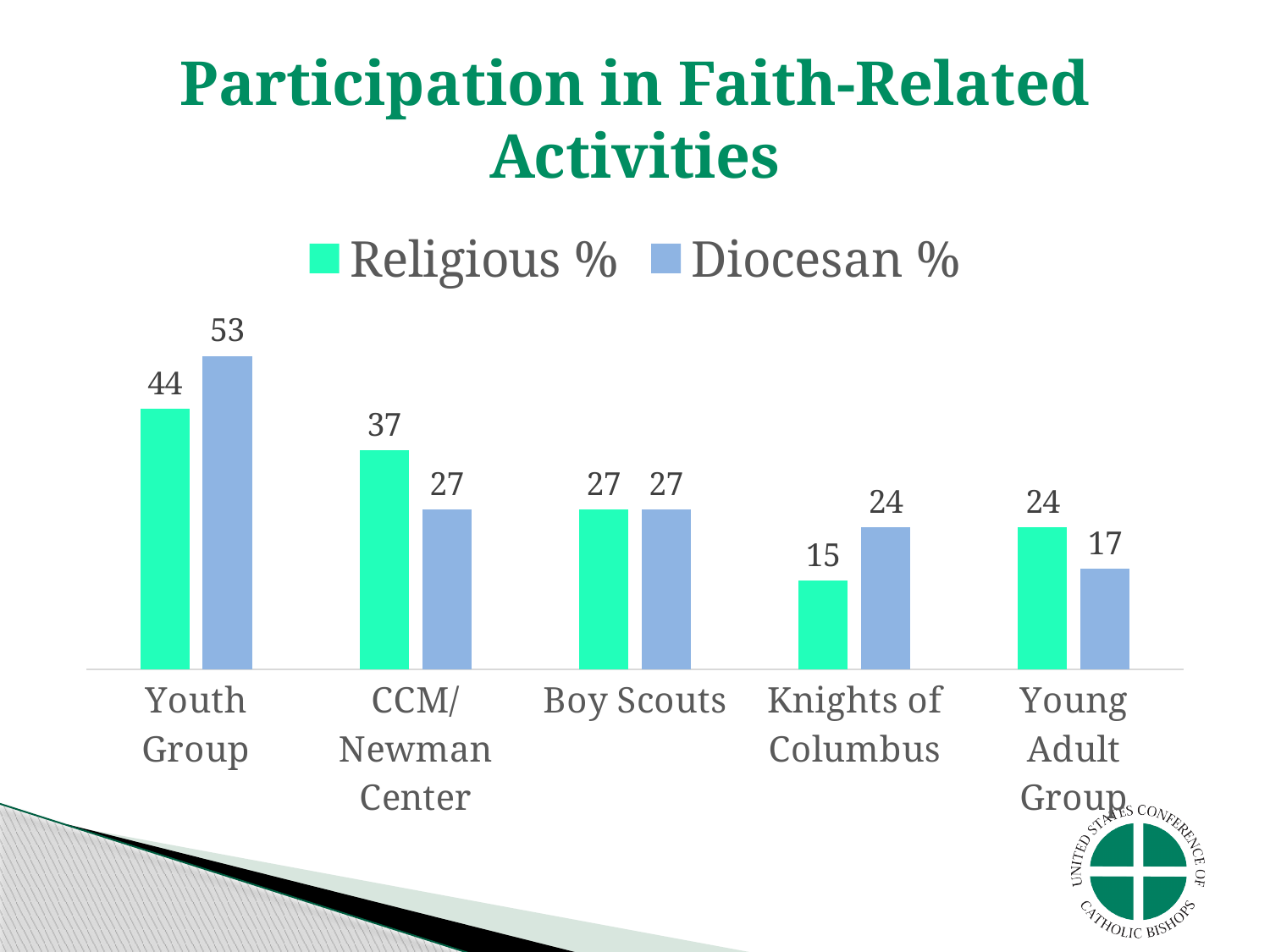
What is the title of the chart? Participation in Faith-Related Activities What is the difference between the Religious % values for CCM/Newman Center and Young Adult Group? 13 Which category has the highest Diocesan % value? Youth Group What kind of chart is shown on the slide? Bar chart Which category has the lowest Religious % value? Knights of Columbus What is the difference between the Diocesan % and Religious % values for Youth Group? 9 How many categories are shown on the x axis? 5 Which is larger for Young Adult Group, the Religious % or the Diocesan % value? Religious % What is the Diocesan % value for Knights of Columbus? 24 How many series does the legend list? 2 What is the Diocesan % value for CCM/Newman Center? 27 What is the Religious % value for Youth Group? 44